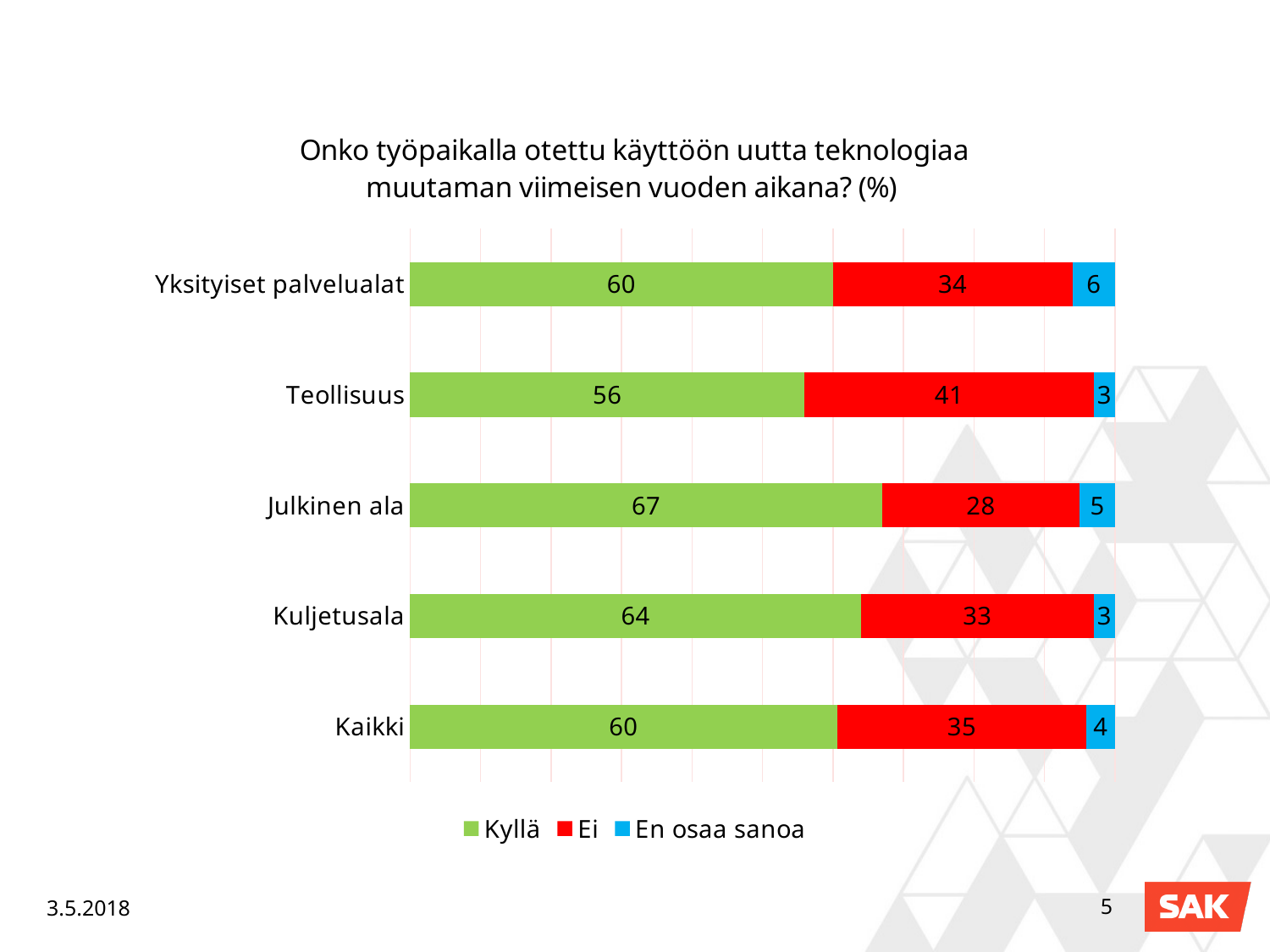
What is the En osaa sanoa value for Yksityiset palvelualat? 6 How many categories are shown on the chart? 5 Which colour represents the Ei series? Red What is the Kyllä value for Julkinen ala? 67 What is the total of the stacked bar for Kaikki? 99 Which is larger, the Kyllä value for Kuljetusala or the Kyllä value for Kaikki? Kuljetusala Which category has the lowest Kyllä value? Teollisuus What kind of chart is shown on the slide? Stacked bar chart What is the Ei value for Teollisuus? 41 How many series does the legend list? 3 Which category has the highest Kyllä value? Julkinen ala What is the difference between the Ei values for Teollisuus and Julkinen ala? 13